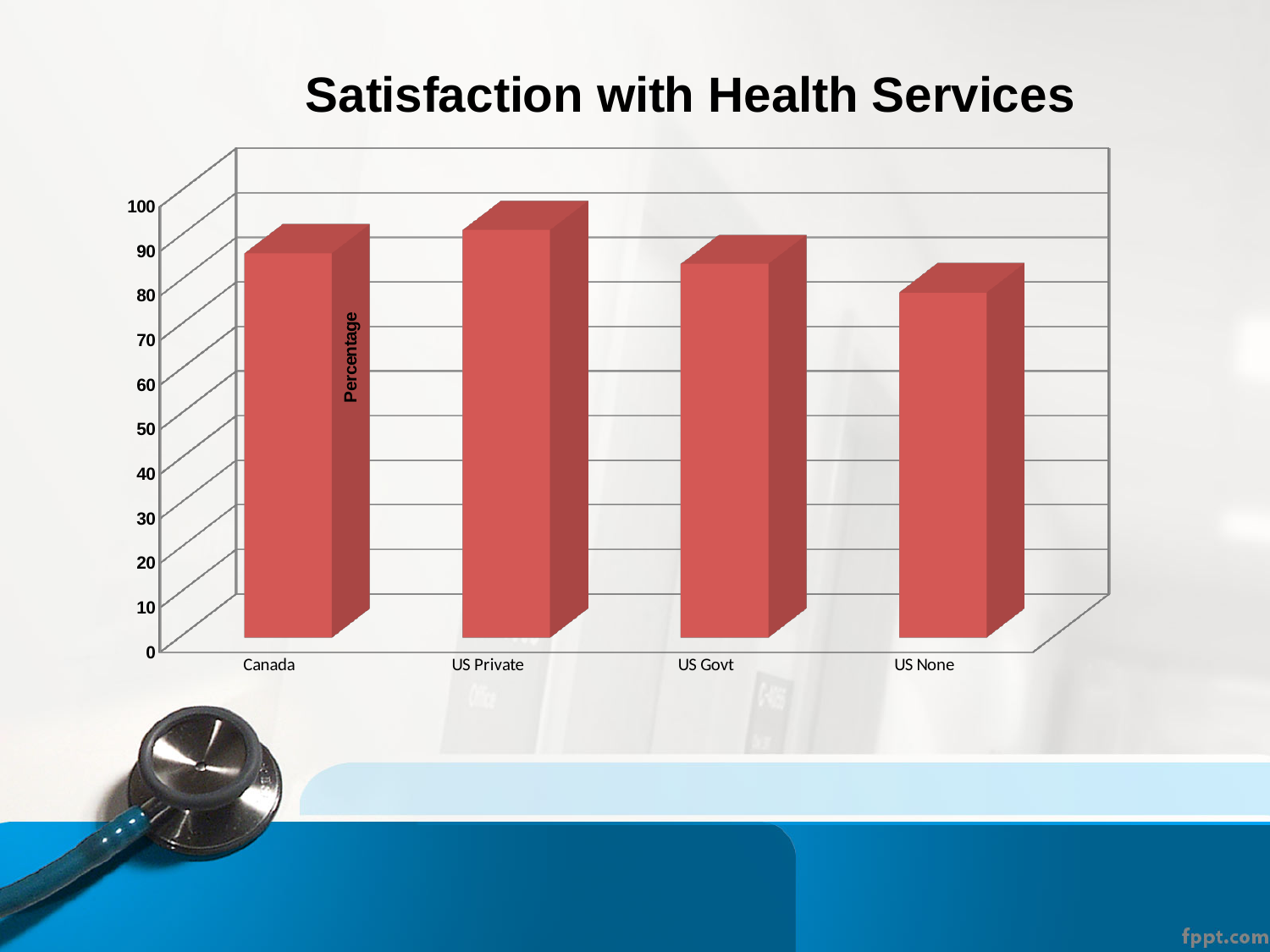
What is the title of the chart? Satisfaction with Health Services What kind of chart is shown on the slide? bar chart Is the value for Canada greater or less than 80? greater Is the value for US None greater or less than 90? less How many categories are plotted in the chart? 4 Which is larger, the value for Canada or the value for US None? Canada What is the label on the vertical axis of the chart? Percentage Is the value for US Private greater or less than 80? greater Which category has the highest satisfaction percentage? US Private Which is larger, the value for US Private or the value for US Govt? US Private Which category has the lowest satisfaction percentage? US None